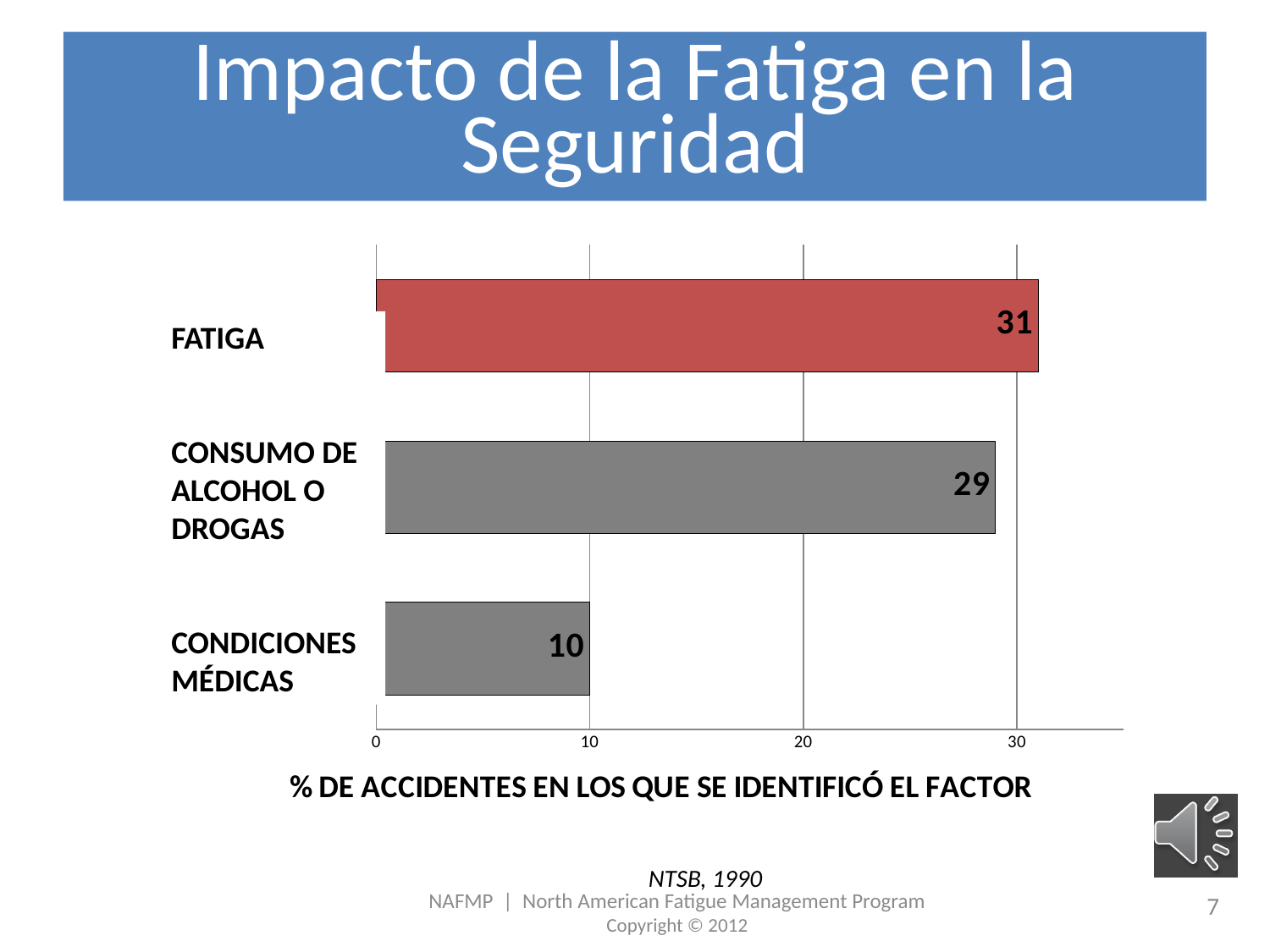
Which is larger, the value for CONSUMO DE ALCOHOL O DROGAS or the value for CONDICIONES MÉDICAS? CONSUMO DE ALCOHOL O DROGAS Is the value for CONSUMO DE ALCOHOL O DROGAS greater or less than 20? greater Which category has the highest value? FATIGA What is the difference between the values for FATIGA and CONSUMO DE ALCOHOL O DROGAS? 2 What is the difference between the values for FATIGA and CONDICIONES MÉDICAS? 21 What is the value for CONDICIONES MÉDICAS? 10 Which category has the lowest value? CONDICIONES MÉDICAS What is the label of the horizontal axis of the chart? % DE ACCIDENTES EN LOS QUE SE IDENTIFICÓ EL FACTOR How many categories are shown in the chart? 3 What kind of chart is shown on the slide? bar chart What is the value for CONSUMO DE ALCOHOL O DROGAS? 29 What is the value for FATIGA? 31